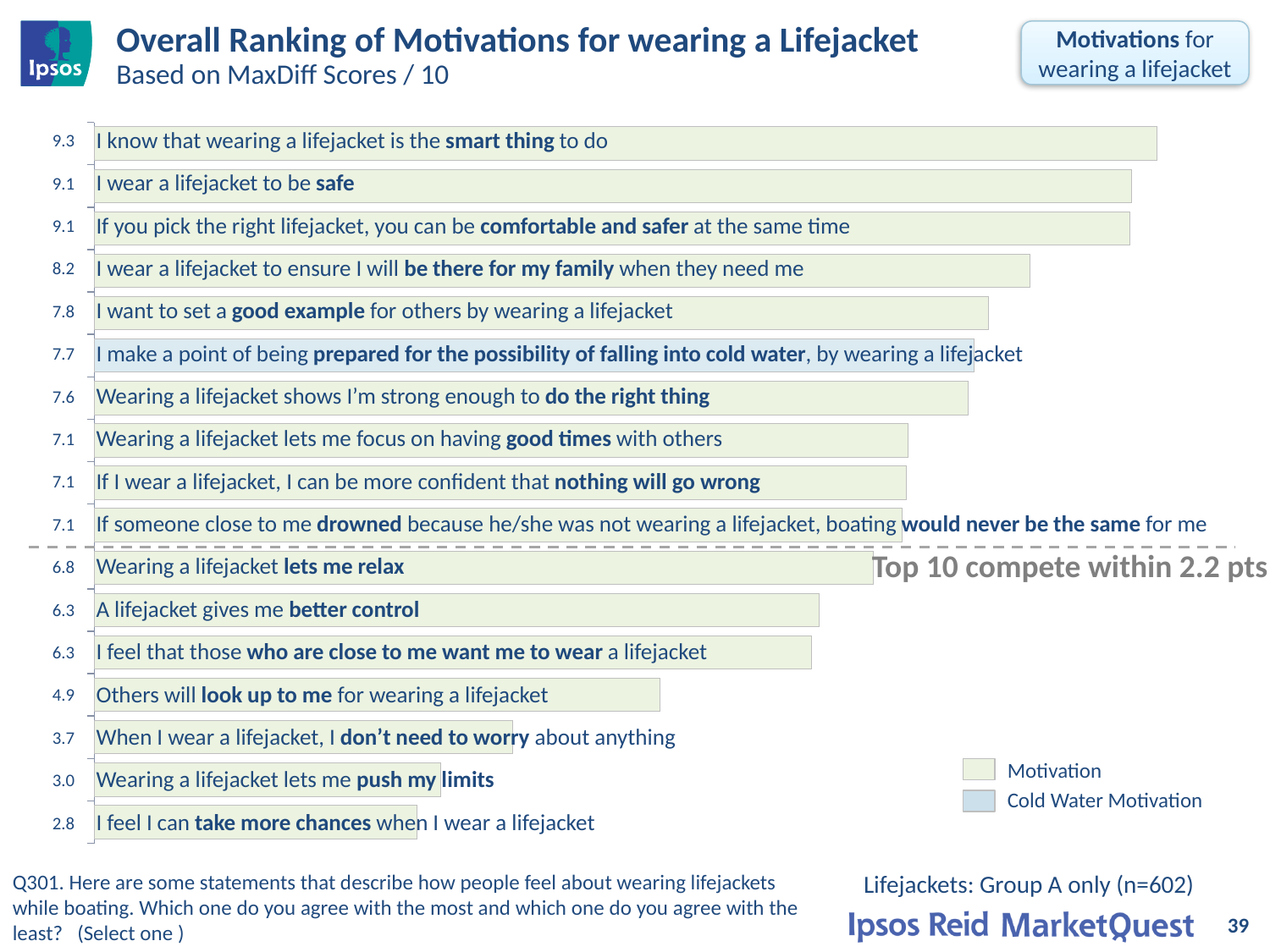
What is the MaxDiff score for "I make a point of being prepared for the possibility of falling into cold water, by wearing a lifejacket"? 7.7 What is the MaxDiff score for "I know that wearing a lifejacket is the smart thing to do"? 9.3 How many entries does the legend list? 2 What is the MaxDiff score for "Others will look up to me for wearing a lifejacket"? 4.9 What is the difference between the MaxDiff scores for "I wear a lifejacket to be safe" and "Wearing a lifejacket lets me relax"? 2.3 Which statement is shown in the "Cold Water Motivation" colour? I make a point of being prepared for the possibility of falling into cold water, by wearing a lifejacket Which has a higher MaxDiff score: "I want to set a good example for others by wearing a lifejacket" or "A lifejacket gives me better control"? I want to set a good example for others by wearing a lifejacket How many statements are ranked in the chart? 17 Which statement has the highest MaxDiff score? I know that wearing a lifejacket is the smart thing to do What is the MaxDiff score for "I wear a lifejacket to ensure I will be there for my family when they need me"? 8.2 What kind of chart is shown on the slide? Bar chart Which statement has the lowest MaxDiff score? I feel I can take more chances when I wear a lifejacket